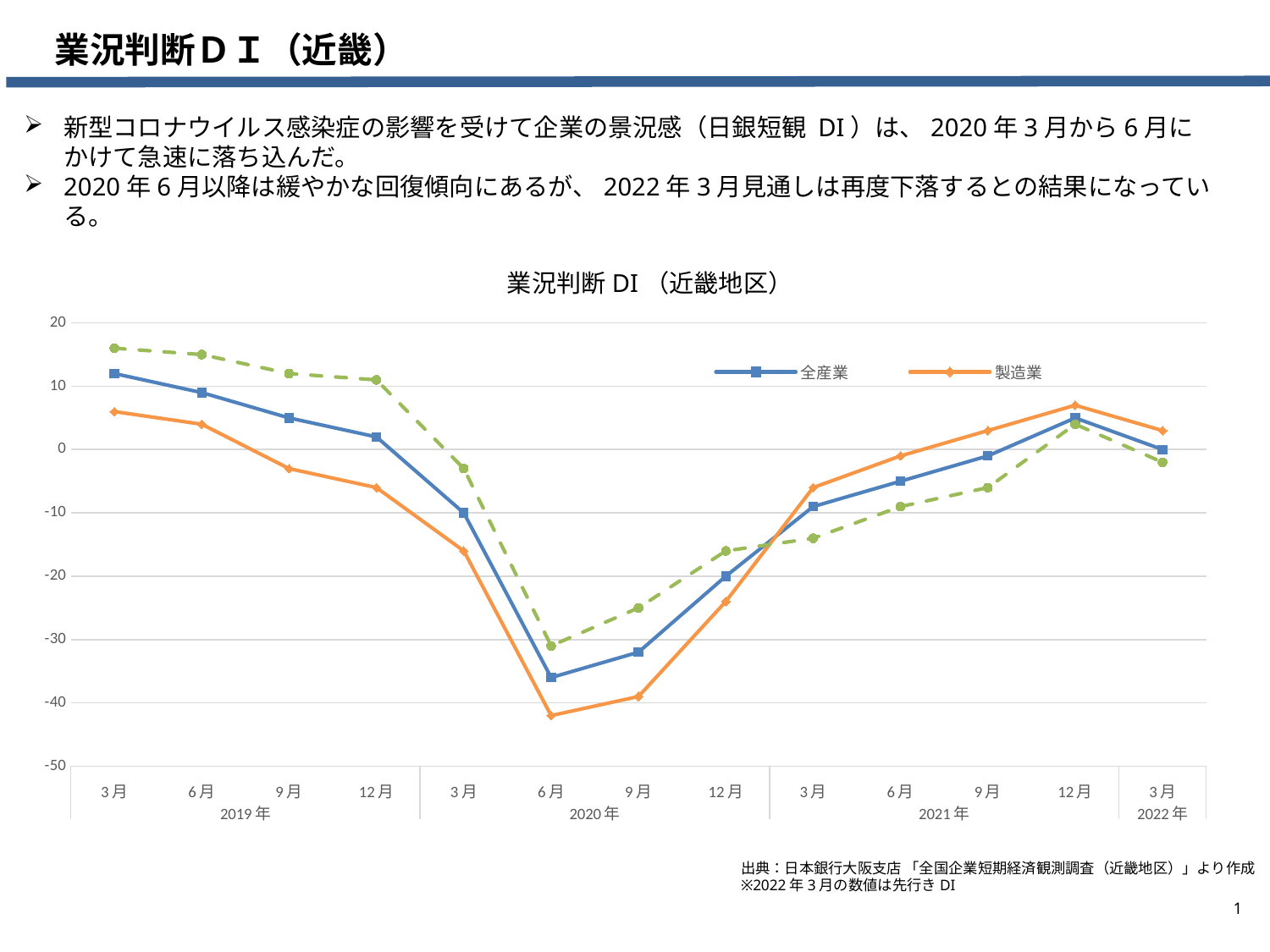
What is the title of the chart? 業況判断DI（近畿地区） What kind of chart is shown on the slide? line chart Which series has the higher value in 2021年12月, 全産業 or 製造業? 製造業 Is the value for 製造業 in 2020年6月 greater or less than -40? less In which period does the 全産業 line reach its lowest value? 2020年6月 Do the values for 全産業 rise or fall from 2020年6月 to 2021年12月? rise Is the value for 全産業 in 2019年3月 greater or less than 10? greater How many series does the chart legend list? 2 Is the value for 製造業 in 2021年12月 greater or less than 0? greater In which period does the 製造業 line reach its lowest value? 2020年6月 Which series has the higher value in 2019年3月, 全産業 or 製造業? 全産業 How many time points are plotted along the x axis? 13